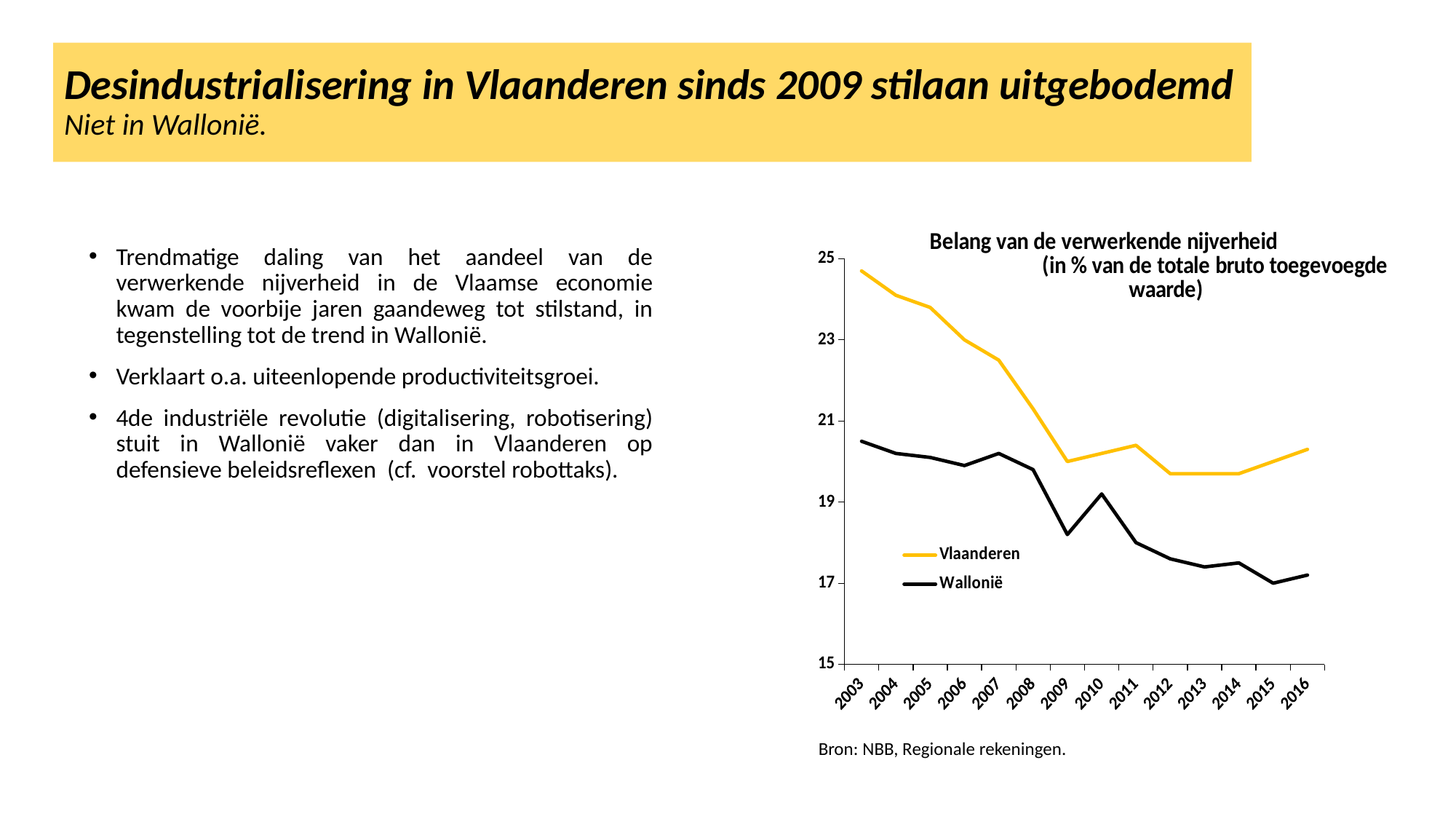
What is the title of the chart? Belang van de verwerkende nijverheid (in % van de totale bruto toegevoegde waarde) Is the value for Wallonië in 2009 greater or less than 19? less In which year is the Vlaanderen series at its highest? 2003 Which series is higher in 2003, Vlaanderen or Wallonië? Vlaanderen How many series does the legend of the chart list? 2 What kind of chart is shown on the slide? line chart What colour is the line for Vlaanderen in the chart? yellow Does the Wallonië series overall rise or fall from 2003 to 2016? fall How many years are plotted along the x axis of the chart? 14 Is the value for Vlaanderen in 2003 greater or less than 23? greater Is the value for Vlaanderen in 2012 greater or less than 21? less In which year is the Wallonië series at its lowest? 2015